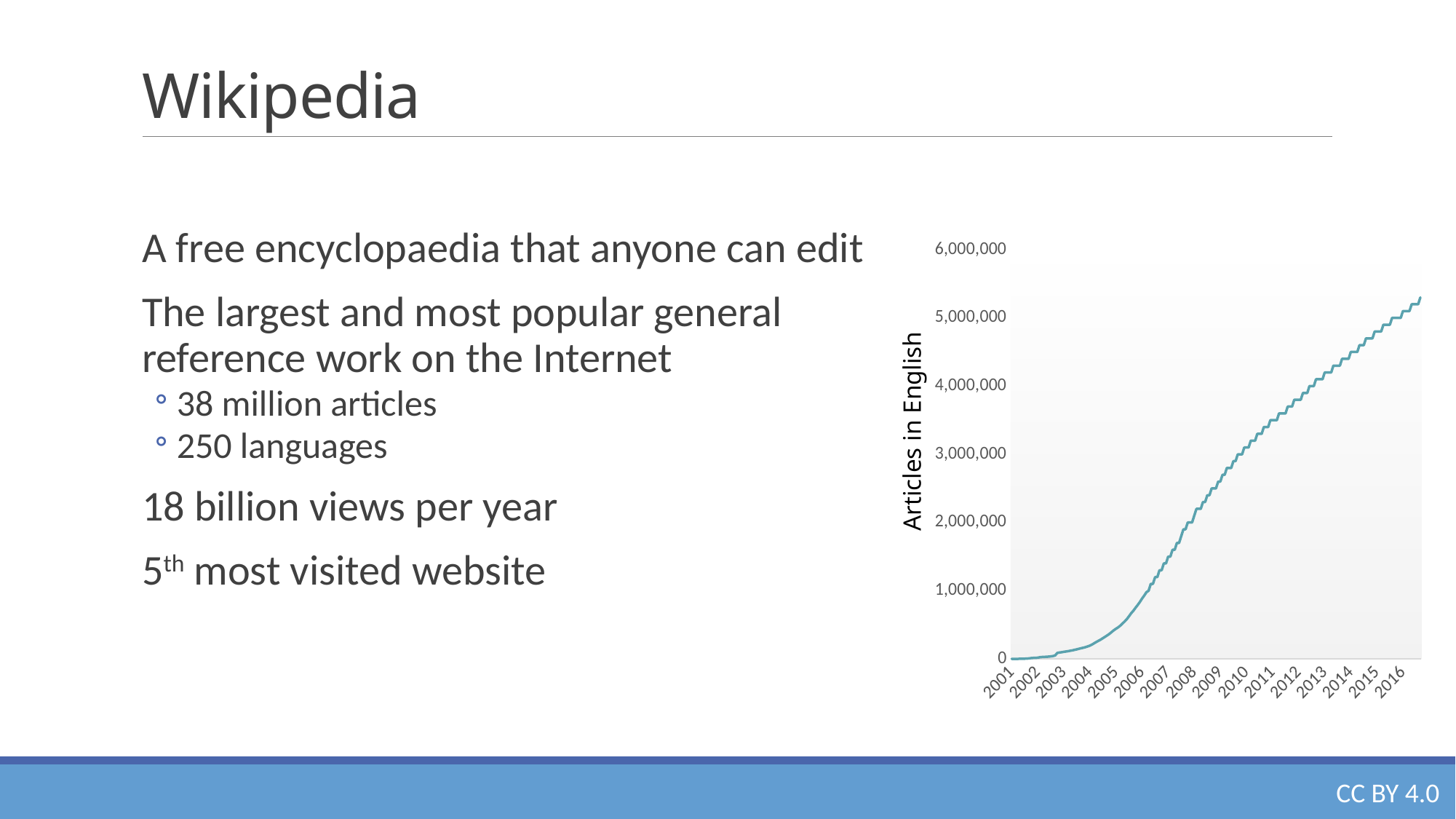
Is the value for 2005 greater or less than 1,000,000? less What is the highest value shown on the vertical axis of the chart? 6,000,000 Which year has more articles in English, 2009 or 2013? 2013 Which year has the lowest number of articles in English in the chart? 2001 Do the values in the chart rise or fall from 2001 to 2016? rise Which year has the highest number of articles in English in the chart? 2016 What kind of chart is shown on the slide? line chart Is the value for 2014 greater or less than 4,000,000? greater How many years are labelled on the horizontal axis of the chart? 16 What is the label on the vertical axis of the chart? Articles in English Is the value for 2016 greater or less than 5,000,000? greater